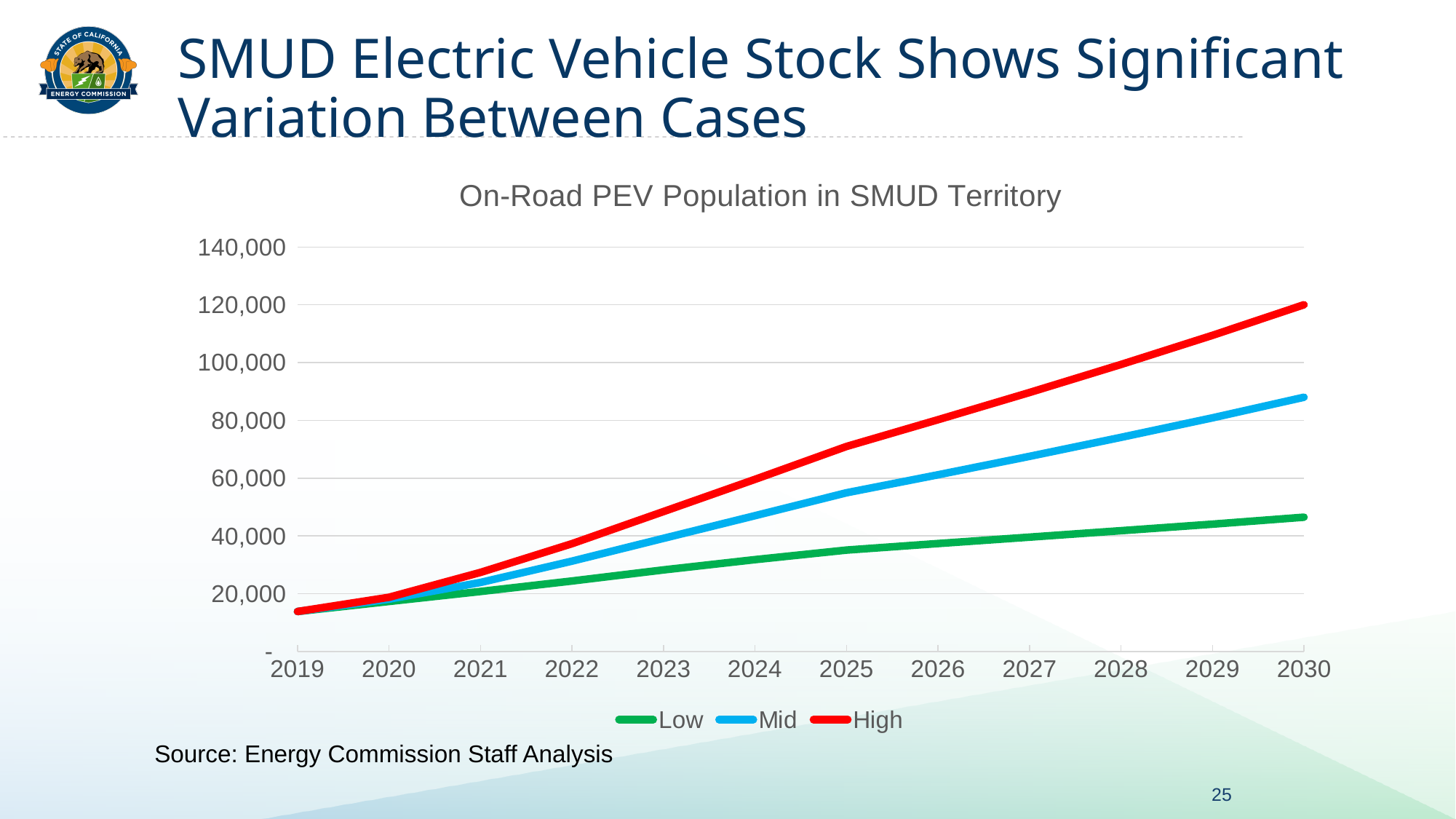
Which is larger in 2030, the Mid series or the Low series? Mid Is the value for the High series in 2030 greater or less than 100,000? greater Is the value for the High series in 2025 greater or less than 60,000? greater Which series has the highest value in 2030? High Which series has the lowest value in 2030? Low Is the value for the Low series in 2025 greater or less than 40,000? less How many years are shown along the x axis? 12 How many series does the legend list? 3 Do the values of the High series rise or fall from 2019 to 2030? rise What kind of chart is shown on the slide? line chart